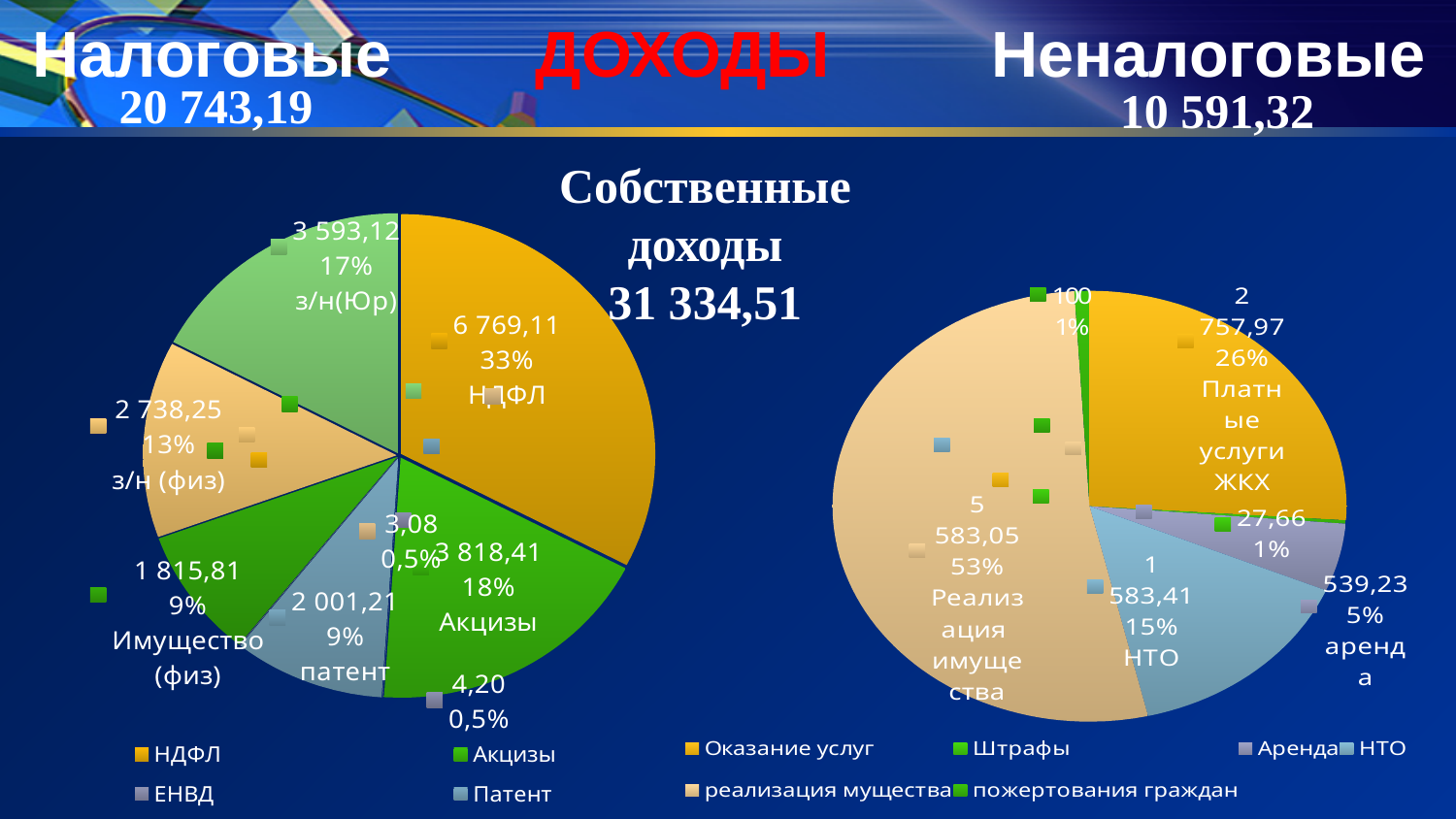
On the right pie chart (Неналоговые), which is larger: НТО or аренда? НТО On the left pie chart (Налоговые), which is larger: з/н (физ) or Имущество (физ)? з/н (физ) On the left pie chart (Налоговые), what is the difference between the values for НДФЛ and Акцизы? 2 950,70 On the left pie chart (Налоговые), what is the value shown for НДФЛ? 6 769,11 On the left pie chart (Налоговые), which category has the largest slice? НДФЛ On the right pie chart (Неналоговые), what share of the pie do Платные услуги ЖКХ represent? 26% On the left pie chart (Налоговые), what share of the pie does Акцизы represent? 18% How many entries does the legend of the right pie chart (Неналоговые) list? 6 On the right pie chart (Неналоговые), which category has the largest slice? Реализация имущества On the left pie chart (Налоговые), what is the value shown for з/н(Юр)? 3 593,12 On the right pie chart (Неналоговые), what is the value shown for Реализация имущества? 5 583,05 What kind of chart is used on the right side of the slide (Неналоговые)? Pie chart